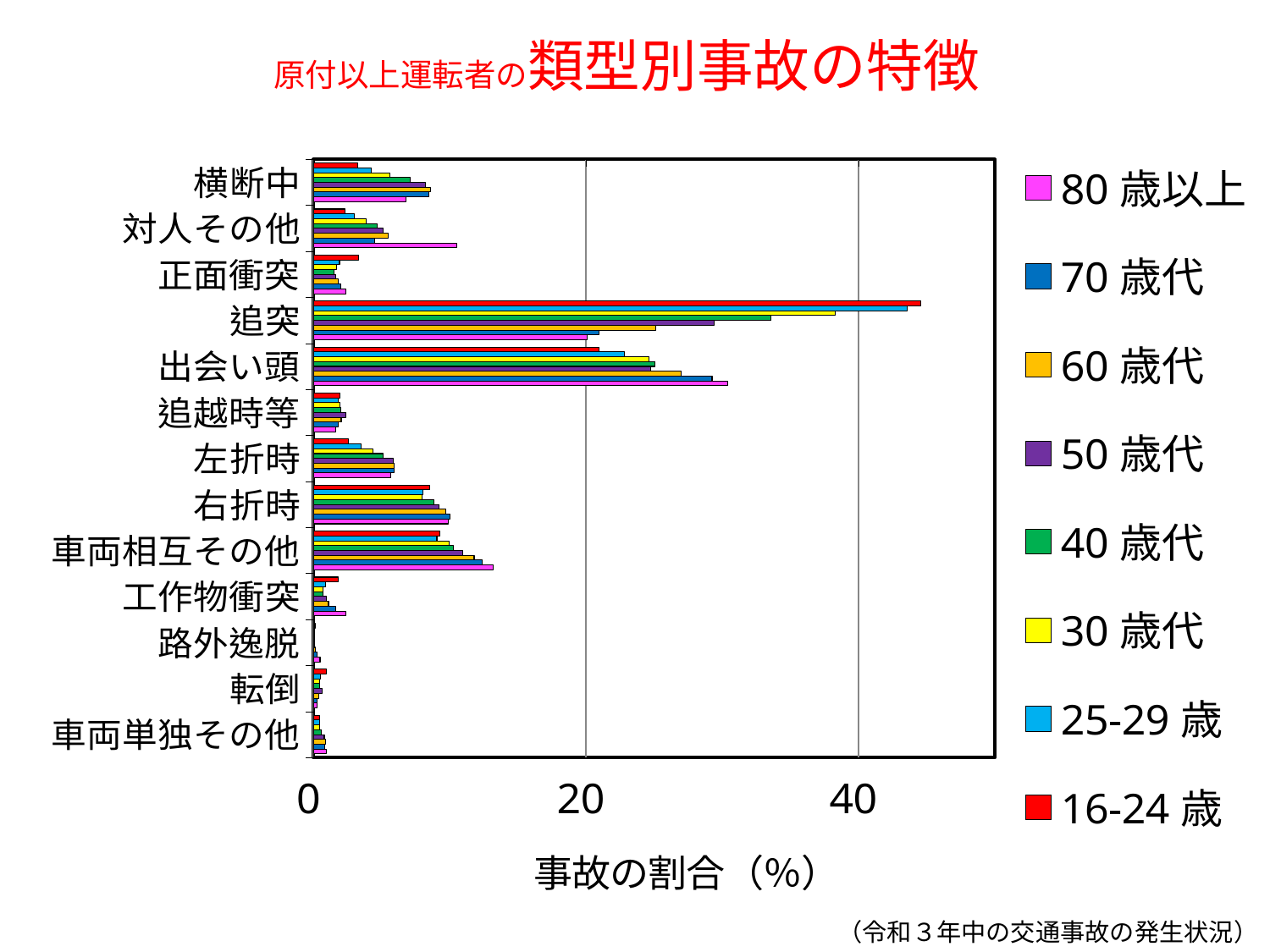
Is the value for 16-24 歳 in the 追突 category greater or less than 40? greater Is the value for 80 歳以上 in the 車両相互その他 category greater or less than 20? less Which category has the highest value for the 16-24 歳 series? 追突 What is the label of the horizontal axis? 事故の割合（%） How many age-group series does the legend list? 8 How many accident-type categories are listed on the vertical axis? 13 Which category has the highest value for the 80 歳以上 series? 出会い頭 In the 対人その他 category, which is larger: the value for 80 歳以上 or for 16-24 歳? 80 歳以上 Is the value for 60 歳代 in the 追突 category greater or less than 20? greater What kind of chart is shown on the slide? bar chart In the 追突 category, which is larger: the value for 16-24 歳 or for 80 歳以上? 16-24 歳